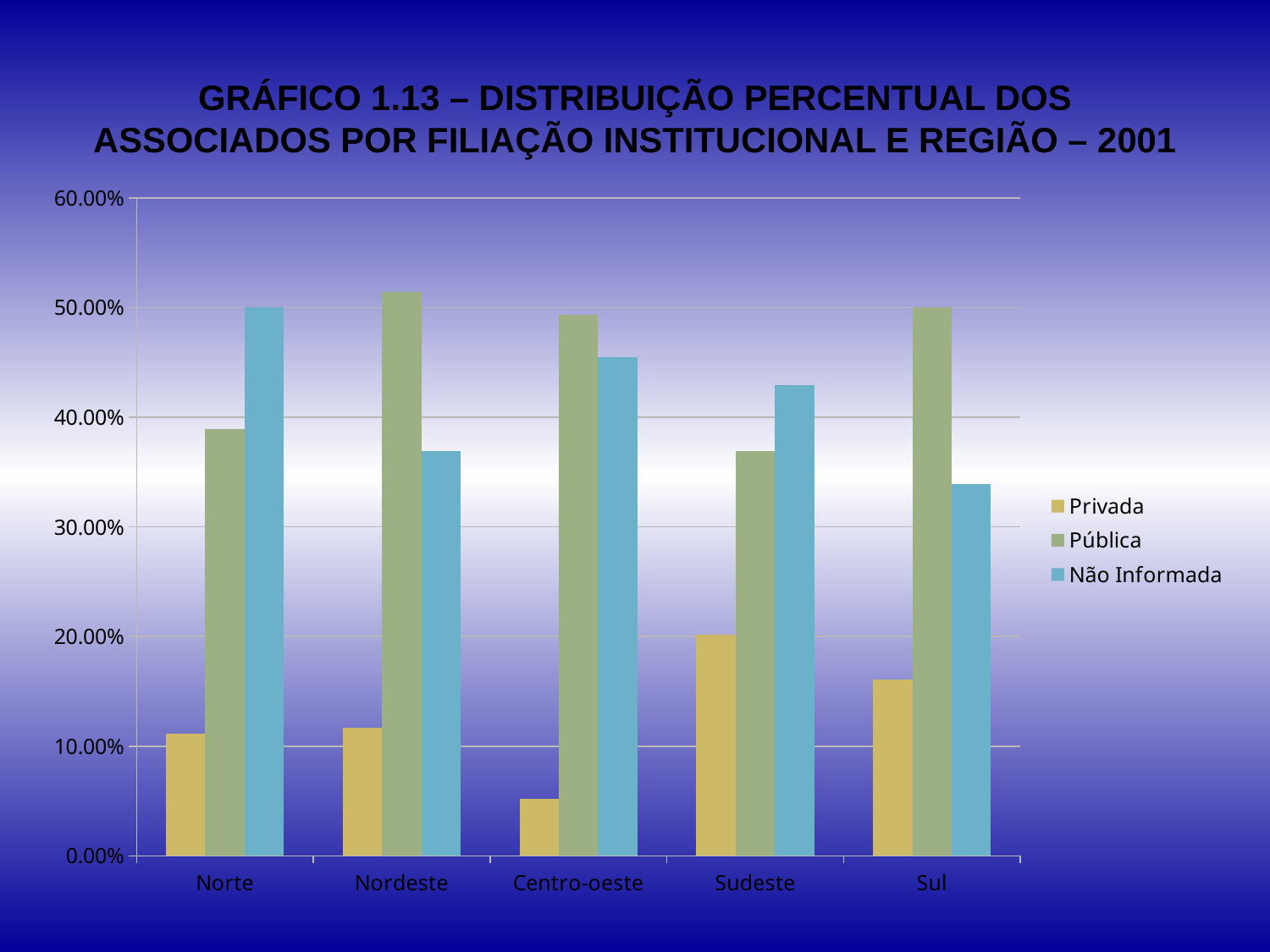
In Norte, which is larger: Pública or Não Informada? Não Informada In Sudeste, which is larger: Pública or Não Informada? Não Informada What kind of chart is shown on the slide? bar chart Is the value for Não Informada in Centro-oeste greater or less than 40.00%? greater Which region has the highest value for Pública? Nordeste Is the value for Privada in Centro-oeste greater or less than 10.00%? less How many regions are shown on the x axis? 5 Which region has the lowest value for Privada? Centro-oeste What are the three series listed in the legend? Privada, Pública, Não Informada Which region has the lowest value for Não Informada? Sul How many series does the legend list? 3 Which region has the highest value for Privada? Sudeste